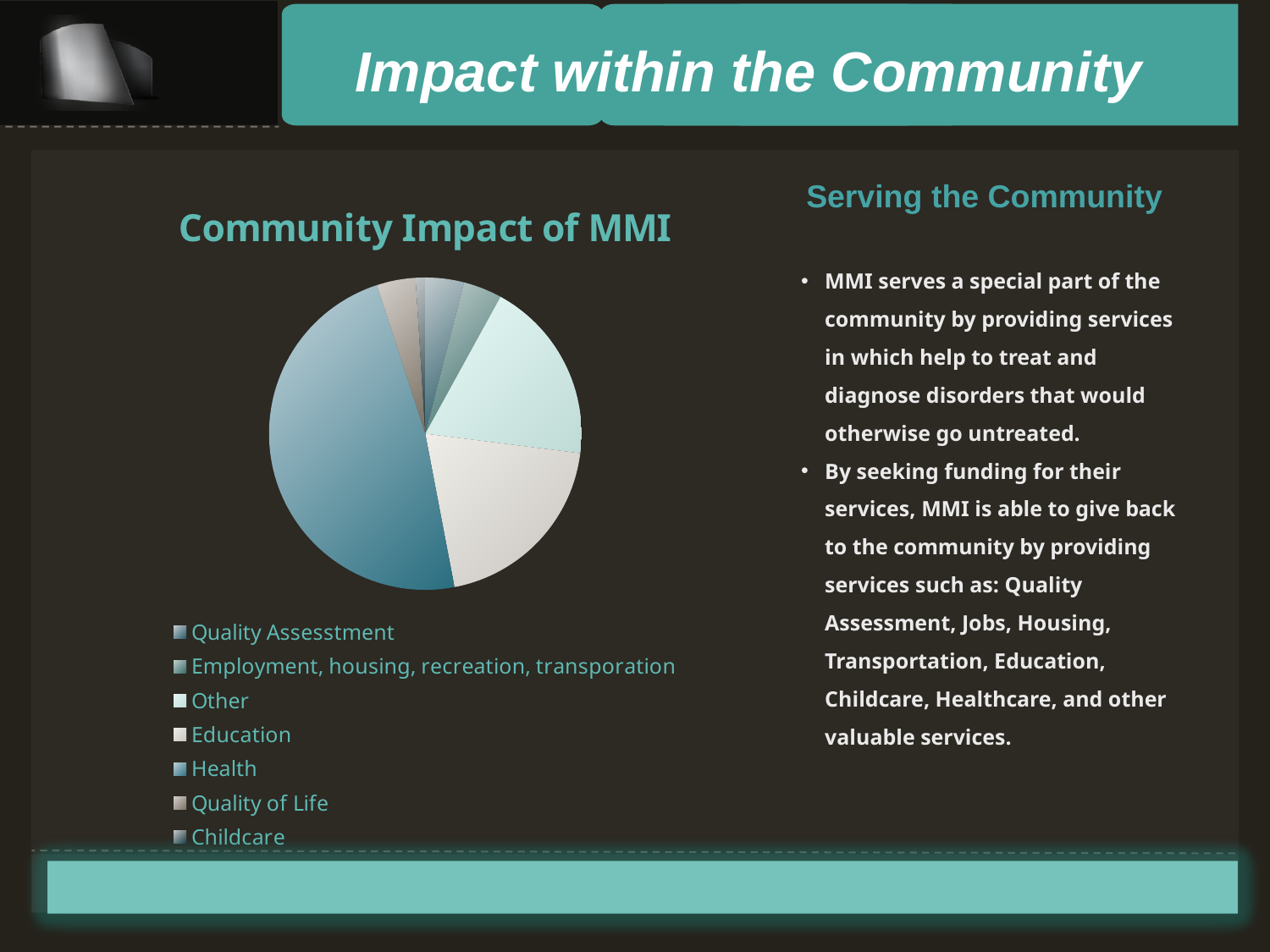
In the "Community Impact of MMI" pie chart, which slice is larger: Quality Assesstment or Other? Other What kind of chart is shown under the title "Community Impact of MMI"? pie chart Which category has the largest slice in the "Community Impact of MMI" pie chart? Health How many categories does the legend of the "Community Impact of MMI" pie chart list? 7 In the "Community Impact of MMI" pie chart, which slice is larger: Quality Assesstment or Education? Education What is the title of the pie chart on the slide? Community Impact of MMI What is the last category listed in the legend of the "Community Impact of MMI" pie chart? Childcare